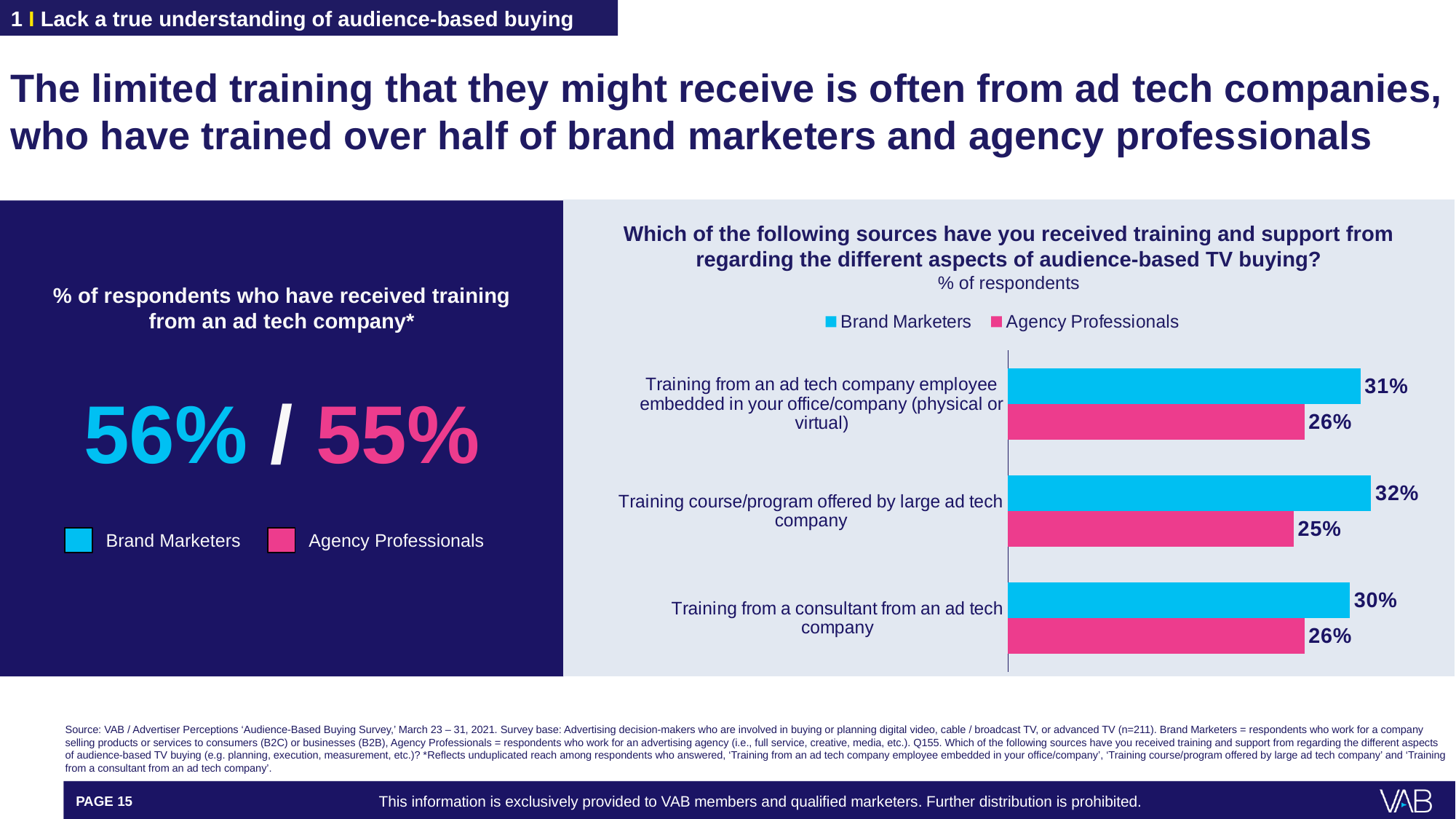
Which colour represents Agency Professionals in the bar chart? Pink How many series does the bar chart's legend list? 2 What percentage of Agency Professionals received training from a consultant from an ad tech company? 26% What percentage of Brand Marketers received training from a consultant from an ad tech company? 30% How many training sources (categories) are shown in the bar chart? 3 What is the difference between Brand Marketers and Agency Professionals for the training course/program offered by a large ad tech company? 7% For training from an ad tech company employee embedded in the office/company, which group has the larger value, Brand Marketers or Agency Professionals? Brand Marketers What type of chart is used to show the training sources? Bar chart What percentage of Agency Professionals received training from a training course/program offered by a large ad tech company? 25% What percentage of Brand Marketers received training from an ad tech company employee embedded in their office/company? 31% Which training source has the lowest value for Agency Professionals? Training course/program offered by large ad tech company Which training source has the highest value for Brand Marketers? Training course/program offered by large ad tech company